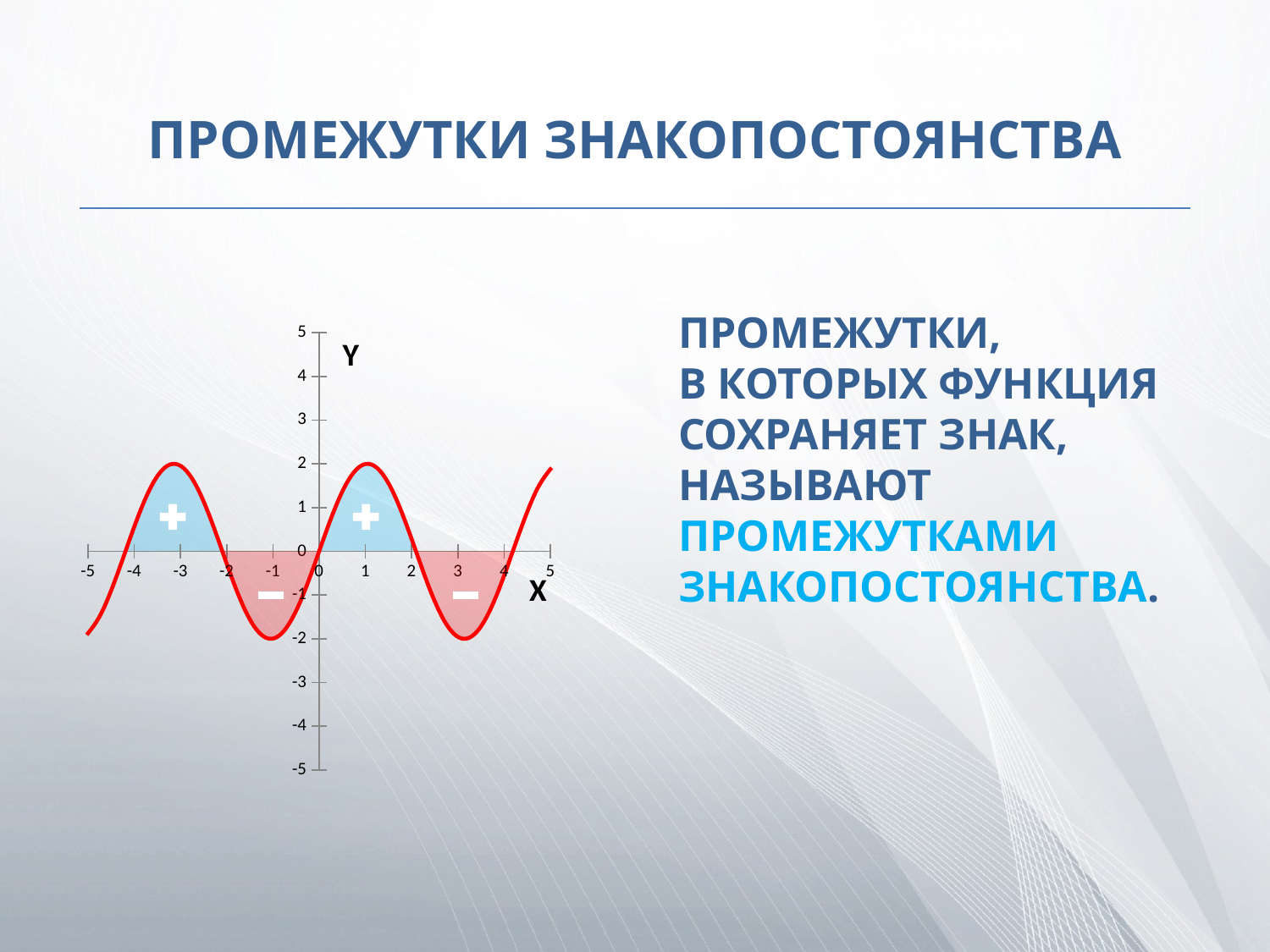
What is the lowest value shown on the x axis? -5 What is the highest value shown on the y axis? 5 Is the value of the curve at x = 3 greater or less than -1? less How many shaded regions are marked with a plus sign? 2 What kind of chart is shown on the slide? line chart Does the curve rise or fall as x goes from -1 to 1? rise Is the value of the curve at x = -3 greater or less than 1? greater Is the value of the curve at x = 1 greater or less than 1? greater Does the curve rise or fall as x goes from 1 to 3? fall How many shaded regions are marked with a minus sign? 2 Which is larger, the value of the curve at x = 1 or at x = 3? x = 1